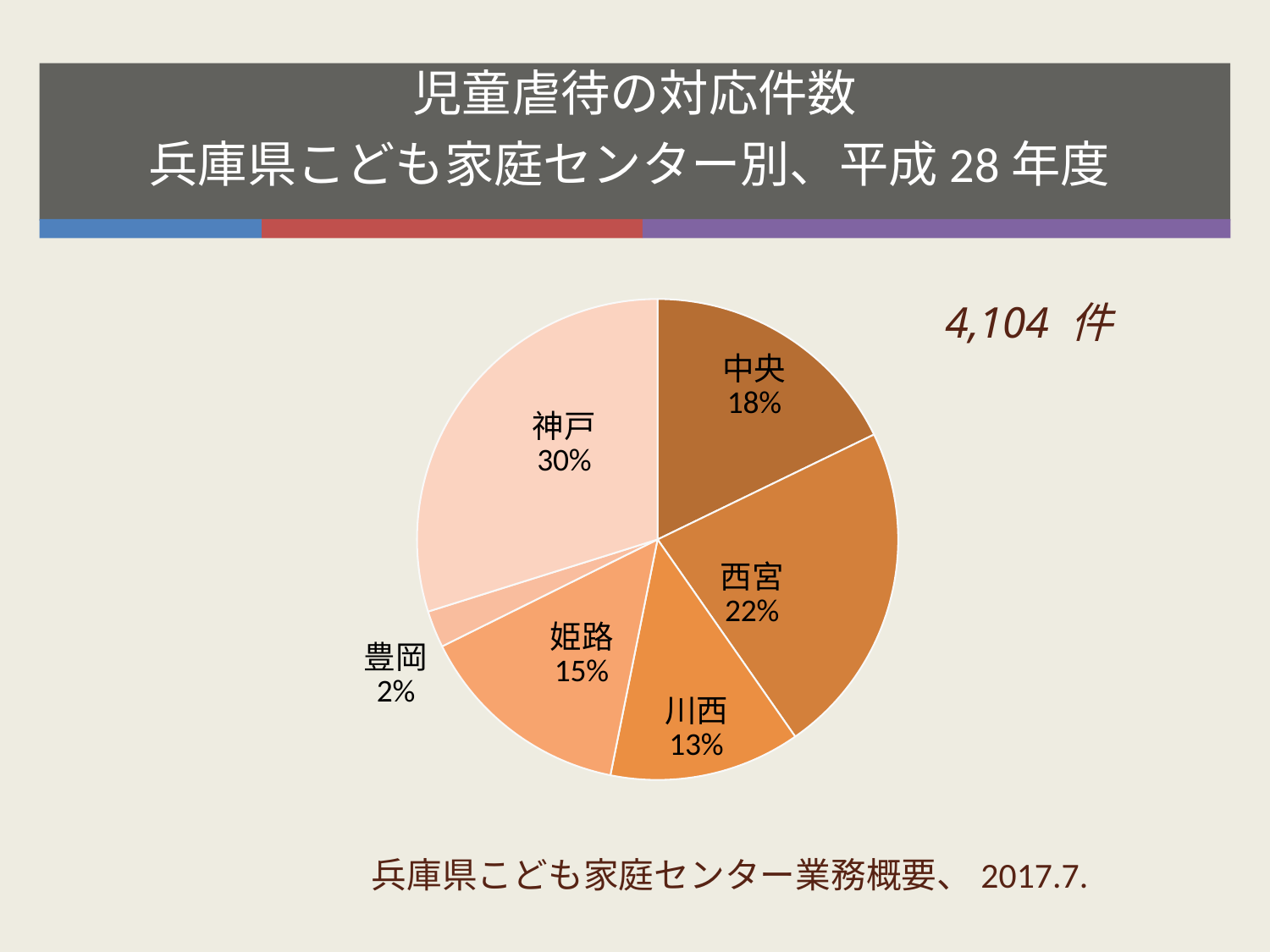
What share of the pie does 豊岡 account for? 2% Which is larger, the share for 西宮 or the share for 中央? 西宮 What share of the pie does 西宮 account for? 22% Which center has the smallest slice of the pie? 豊岡 What share of the pie does 中央 account for? 18% How many slices does the pie chart have? 6 What kind of chart is shown on the slide? pie chart What total number of cases is printed next to the pie chart? 4,104 件 What is the difference in percentage points between 神戸 and 姫路? 15 Which center has the largest slice of the pie? 神戸